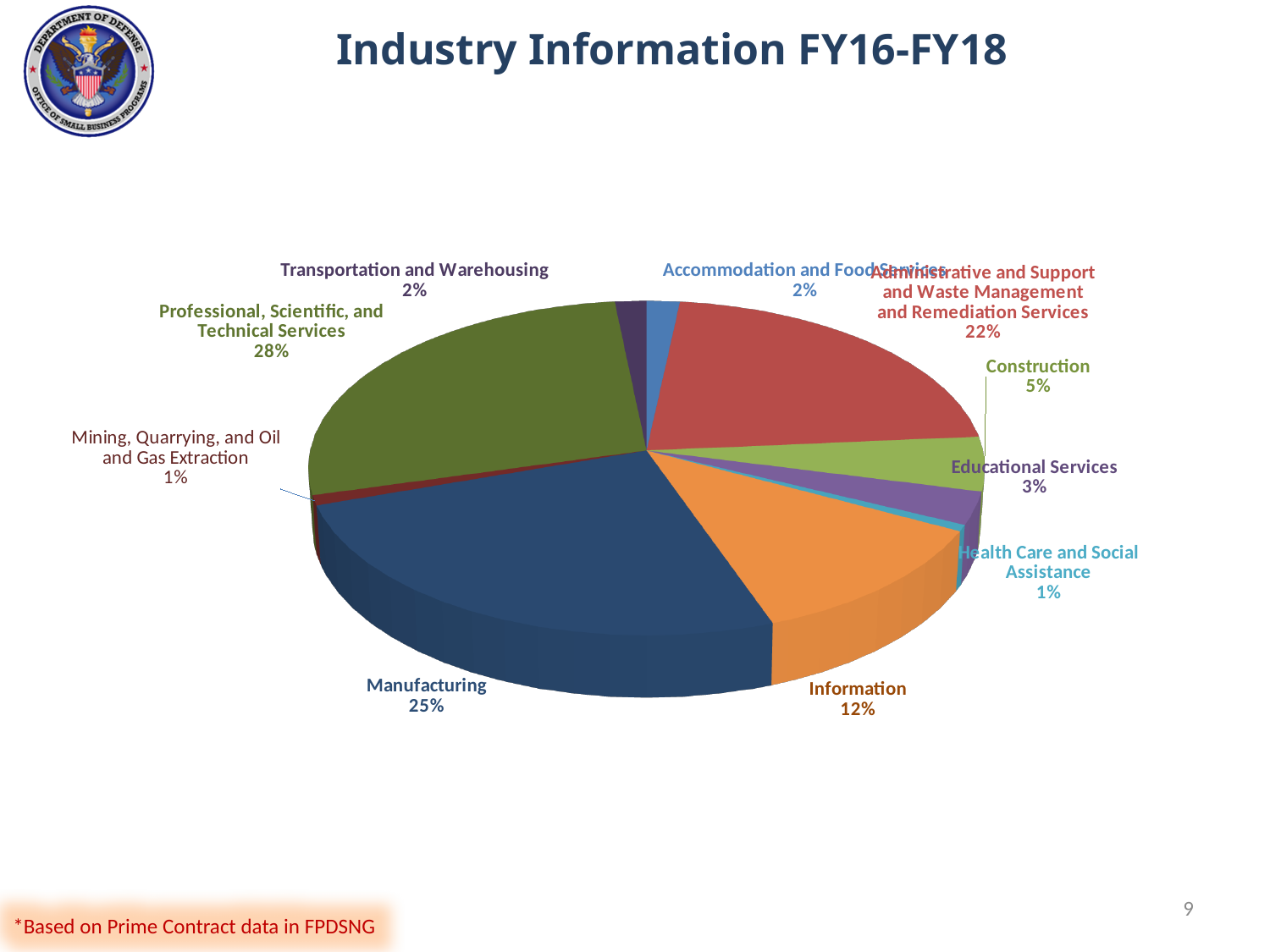
How many industry categories are shown in the pie chart? 10 What share of the pie does Manufacturing represent? 25% What percentage is shown for Construction? 5% Which industry has the largest share of the pie? Professional, Scientific, and Technical Services What percentage is shown for Administrative and Support and Waste Management and Remediation Services? 22% What is the difference in percentage points between Professional, Scientific, and Technical Services and Manufacturing? 3 What kind of chart is shown on the slide? Pie chart Which is larger, the share for Manufacturing or the share for Information? Manufacturing What percentage is shown for Educational Services? 3% What is the title of the chart on the slide? Industry Information FY16-FY18 What percentage is shown for Information? 12% What percentage is shown for Professional, Scientific, and Technical Services? 28%